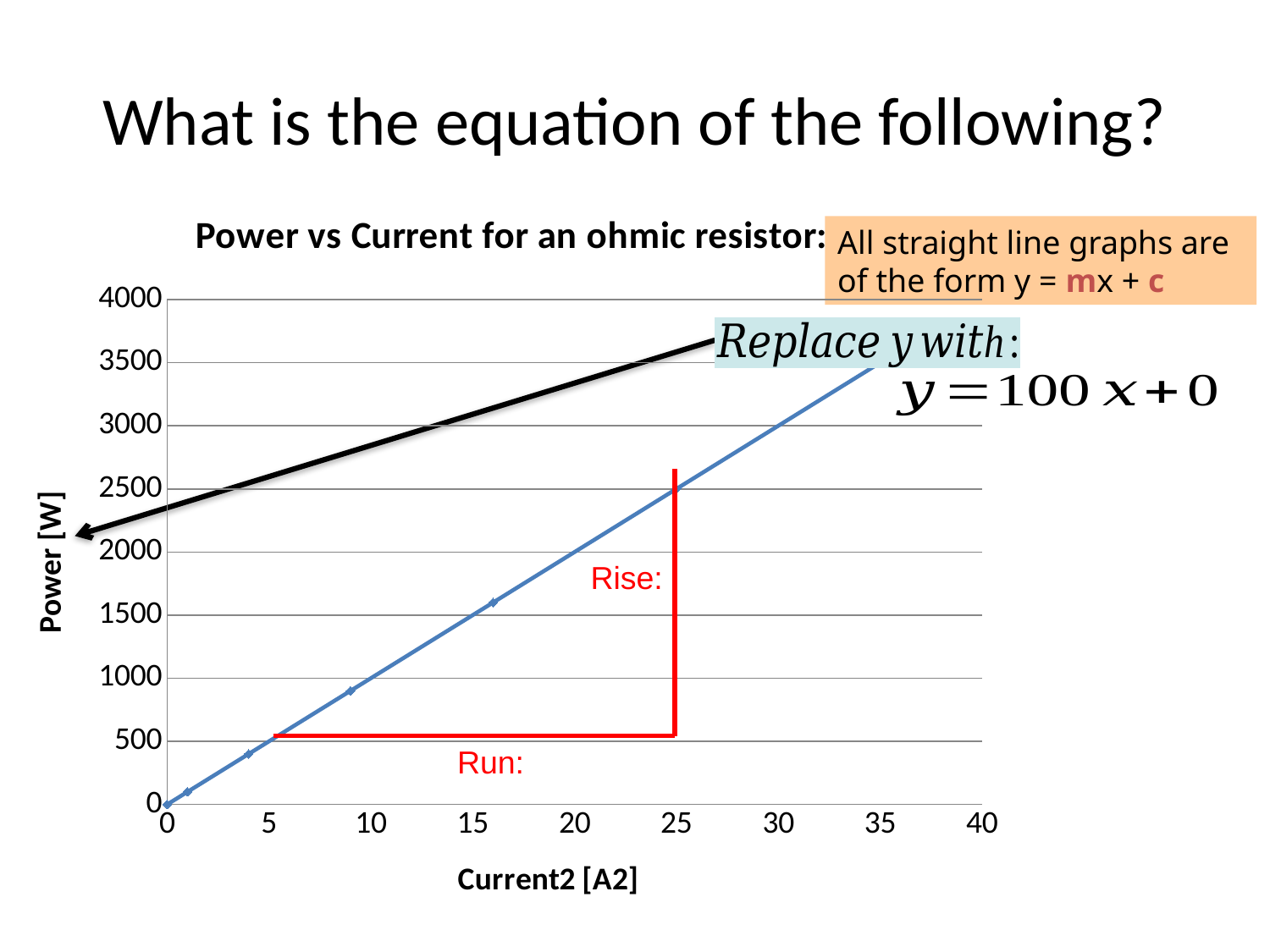
What is the highest value shown on the vertical axis of the chart? 4000 Is the Power value at Current2 = 16 greater or less than 1500? greater What is the title of the chart? Power vs Current for an ohmic resistor: Does the plotted line rise or fall as the x-axis value increases? rises Is the Power value at Current2 = 4 greater or less than 500? less What kind of chart is shown on the slide? line chart What is the label of the vertical axis of the chart? Power [W] Is the Power value at Current2 = 9 greater or less than 1000? less What is the Power value of the plotted point at Current2 = 0? 0 What is the Power value of the plotted point at Current2 = 25? 2500 Which plotted point has the higher Power value, the one at Current2 = 9 or the one at Current2 = 25? Current2 = 25